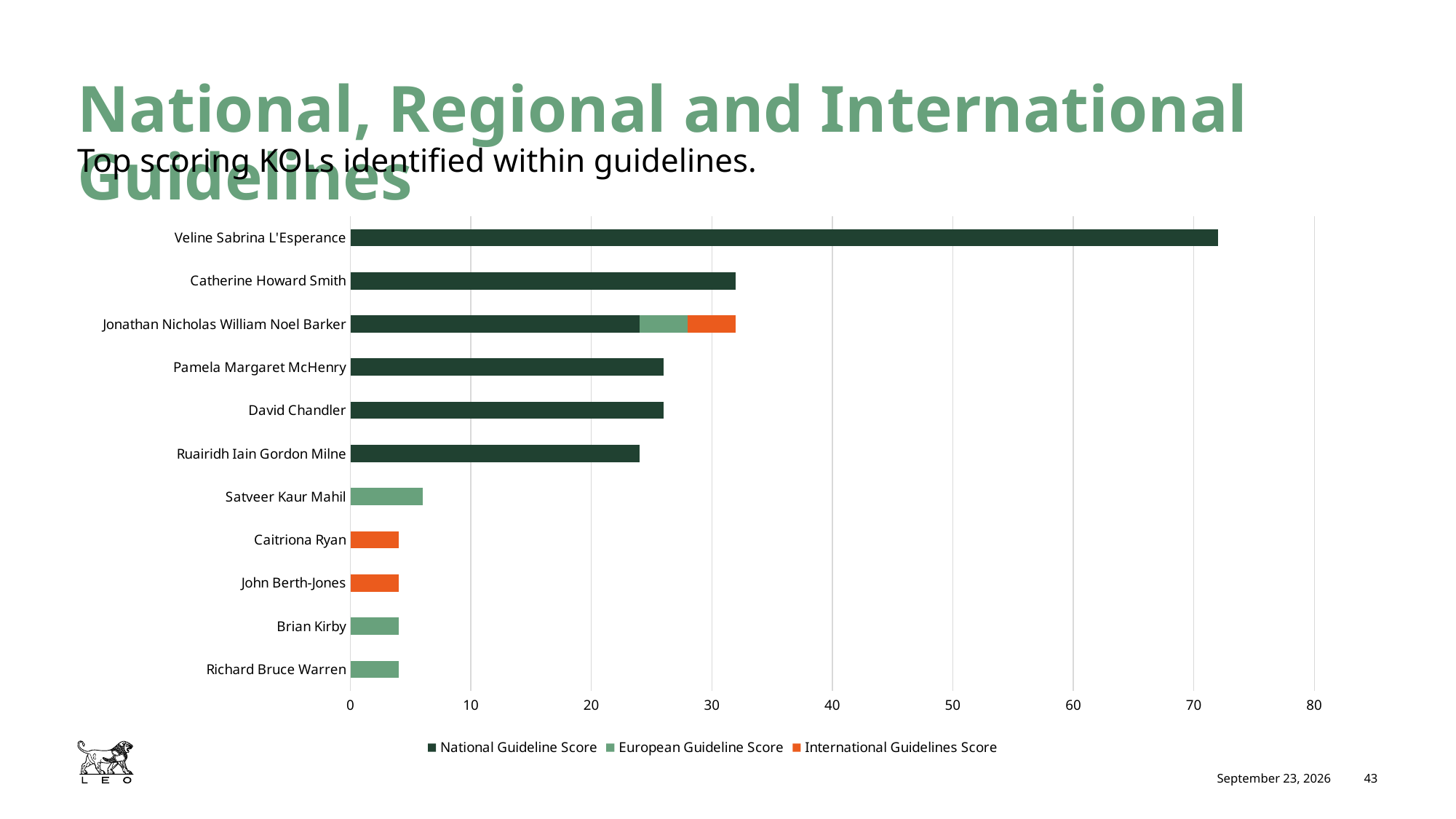
Which KOL has the highest total score? Veline Sabrina L'Esperance Is the total score for Ruairidh Iain Gordon Milne greater or less than 30? less Which has the larger total score, Satveer Kaur Mahil or Caitriona Ryan? Satveer Kaur Mahil Is the total score for Veline Sabrina L'Esperance greater or less than 70? greater Is the total score for Satveer Kaur Mahil greater or less than 10? less Which series is shown in orange in the legend? International Guidelines Score Which has the larger total score, Veline Sabrina L'Esperance or Catherine Howard Smith? Veline Sabrina L'Esperance Which KOL has a bar made up of all three guideline score series? Jonathan Nicholas William Noel Barker How many series does the legend list? 3 What kind of chart is shown on the slide? bar chart How many KOLs (categories) are shown on the chart? 11